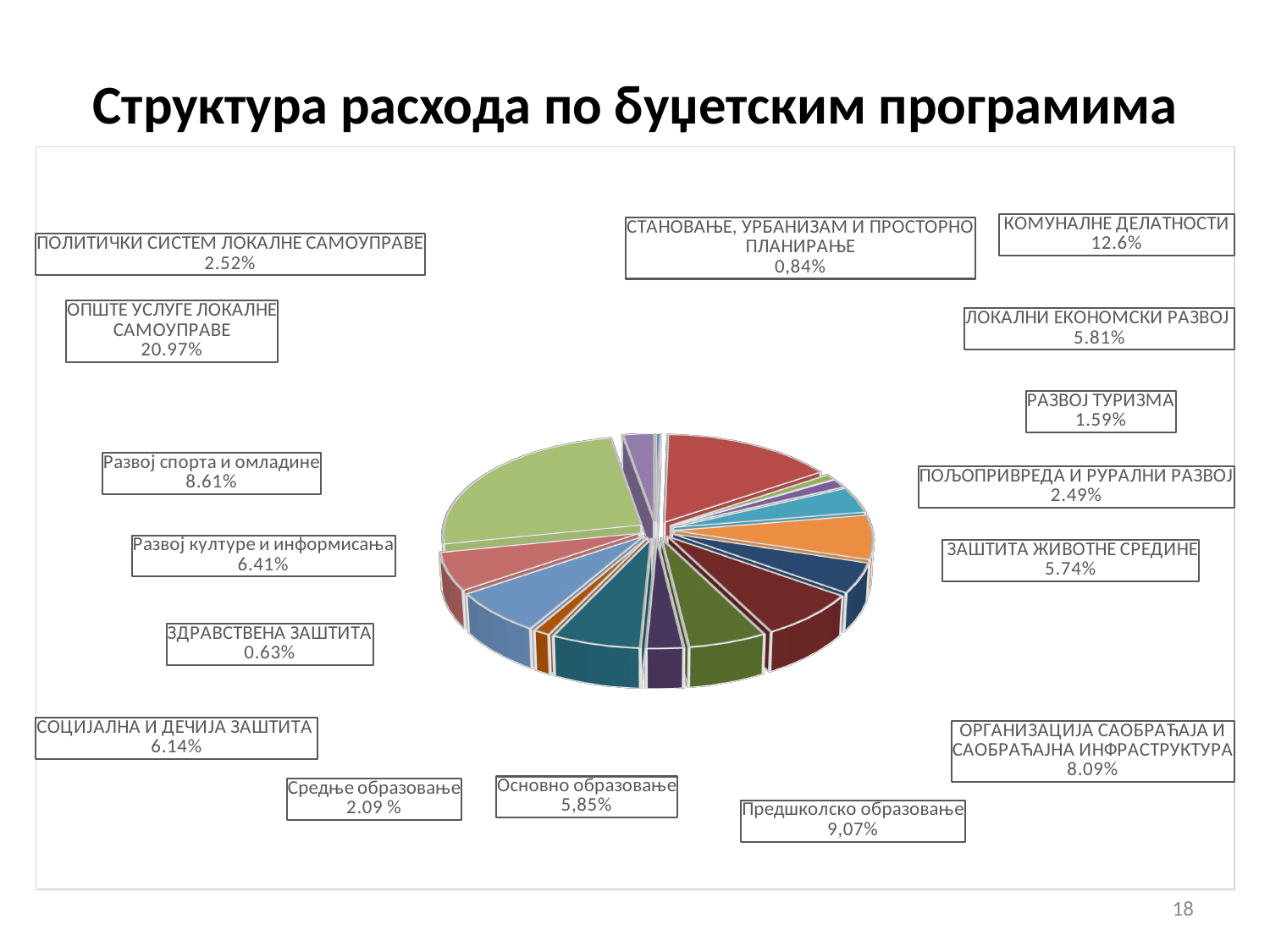
What share is shown for Предшколско образовање? 9,07% What share is shown for КОМУНАЛНЕ ДЕЛАТНОСТИ? 12.6% What is the difference in percentage points between Развој спорта и омладине and Развој културе и информисања? 2.20 percentage points Which program has the largest share of expenditure? ОПШТЕ УСЛУГЕ ЛОКАЛНЕ САМОУПРАВЕ What is the title of the chart? Структура расхода по буџетским програмима What is the difference in percentage points between ОПШТЕ УСЛУГЕ ЛОКАЛНЕ САМОУПРАВЕ and КОМУНАЛНЕ ДЕЛАТНОСТИ? 8.37 percentage points What share is shown for ОПШТЕ УСЛУГЕ ЛОКАЛНЕ САМОУПРАВЕ? 20.97% What type of chart is shown on the slide? Pie chart Which program has the smallest share of expenditure? ЗДРАВСТВЕНА ЗАШТИТА What share is shown for ЗАШТИТА ЖИВОТНЕ СРЕДИНЕ? 5.74% How many program categories are shown in the pie chart? 16 Which has a larger share: Предшколско образовање or Развој спорта и омладине? Предшколско образовање